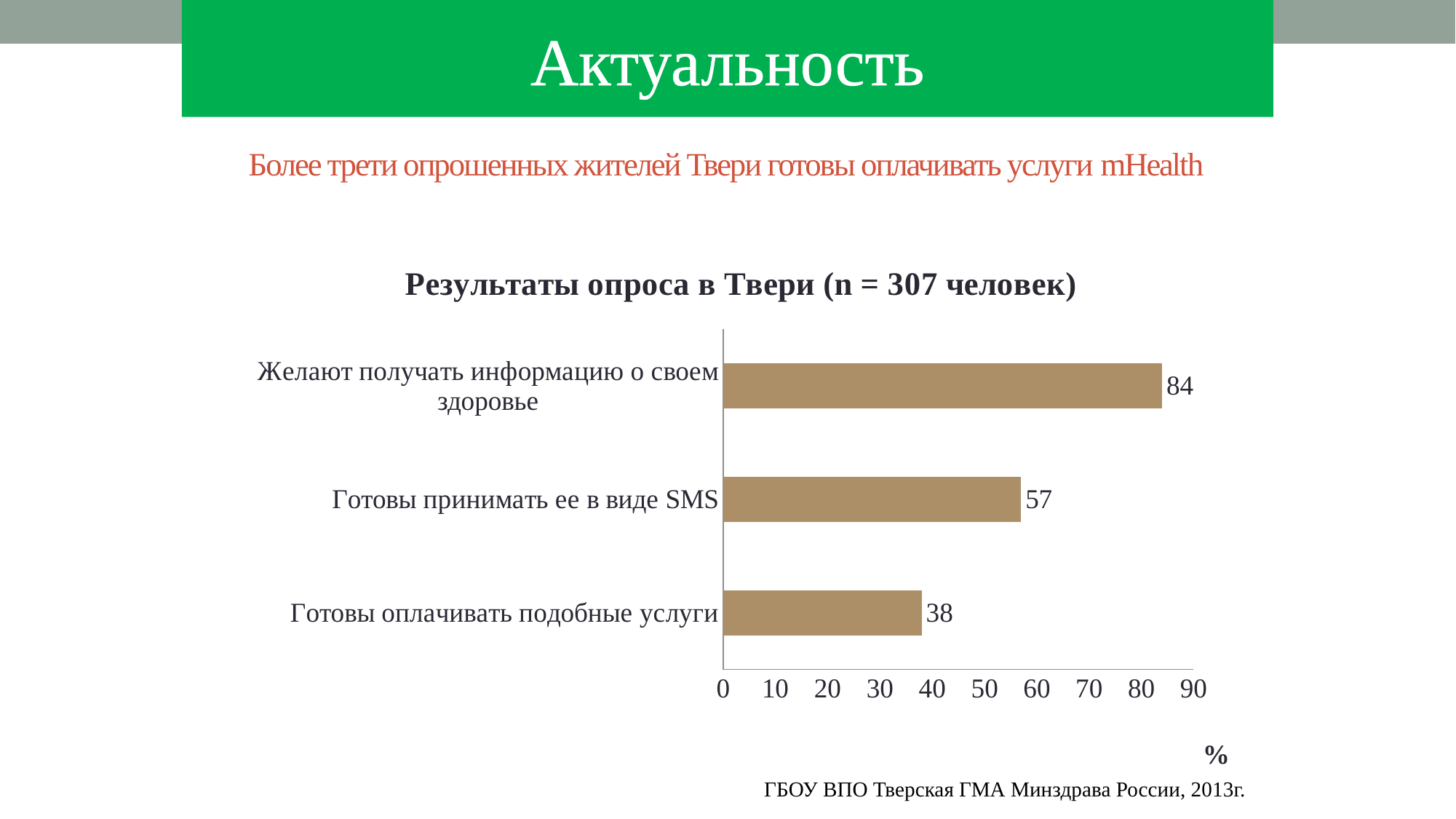
What is the value for "Готовы оплачивать подобные услуги"? 38 What is the title of the chart? Результаты опроса в Твери (n = 307 человек) Which category has the lowest value? Готовы оплачивать подобные услуги How many categories are shown in the chart? 3 What is the value for "Готовы принимать ее в виде SMS"? 57 What is the value for "Желают получать информацию о своем здоровье"? 84 What is the difference between the values for "Готовы принимать ее в виде SMS" and "Готовы оплачивать подобные услуги"? 19 What is the difference between the values for "Желают получать информацию о своем здоровье" and "Готовы оплачивать подобные услуги"? 46 Is the value for "Готовы принимать ее в виде SMS" greater or less than 50? greater Which category has the highest value? Желают получать информацию о своем здоровье Which is larger: the value for "Готовы принимать ее в виде SMS" or for "Готовы оплачивать подобные услуги"? Готовы принимать ее в виде SMS What kind of chart is shown on the slide? bar chart